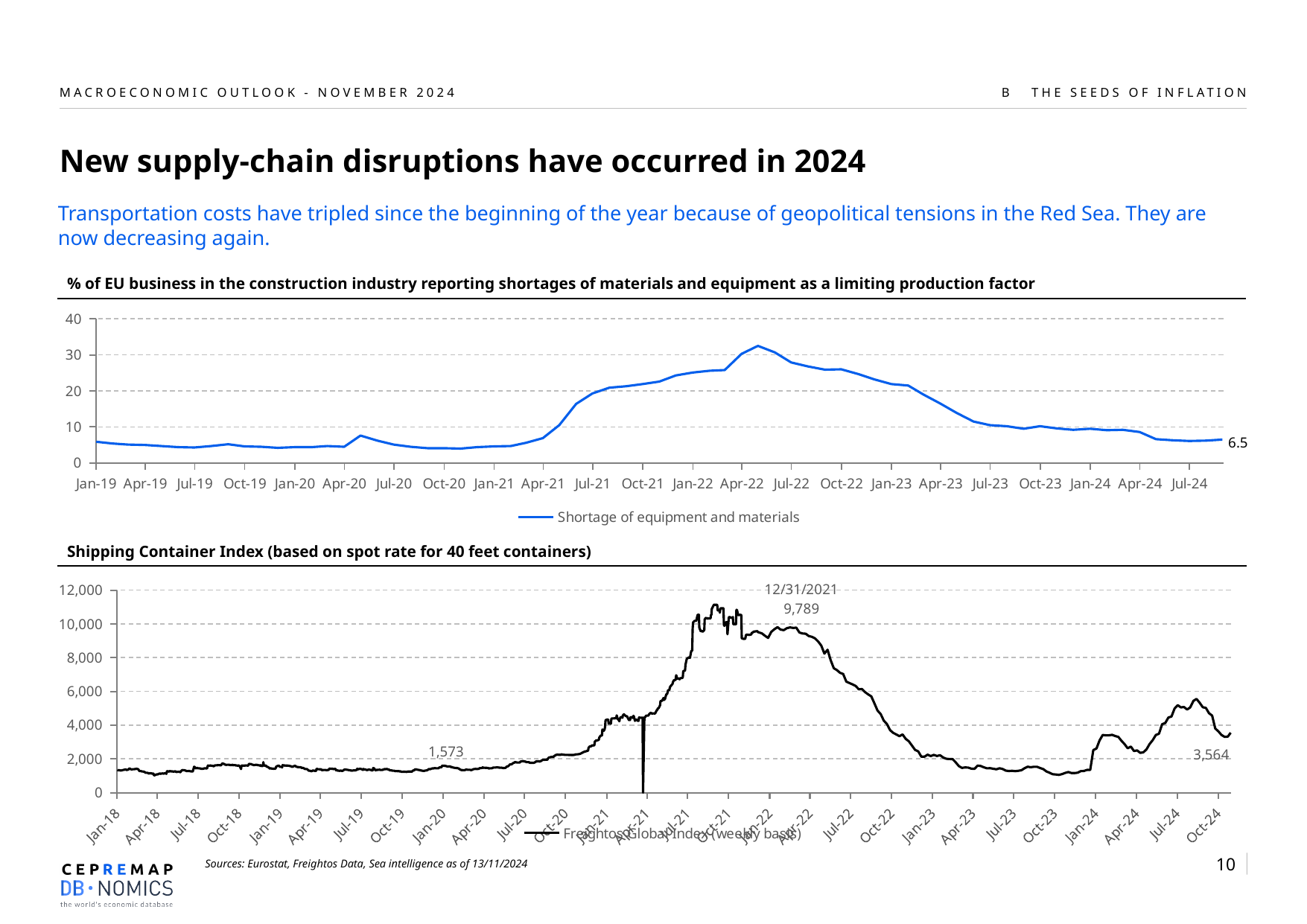
In the bottom chart, 'Shipping Container Index', which is larger: the value labelled for 12/31/2021 or the latest labelled value? 12/31/2021 In the top chart on shortages of materials and equipment, what is the latest value labelled at the end of the line? 6.5 In the bottom chart, 'Shipping Container Index', what value is labelled on the line around Jan-20? 1,573 What kind of chart is the top chart, '% of EU business in the construction industry reporting shortages of materials and equipment as a limiting production factor'? Line chart In the top chart on shortages of materials and equipment, is the peak value around Apr-22 greater or less than 30? greater In the bottom chart, 'Shipping Container Index', what value is labelled for 12/31/2021? 9,789 In the top chart on shortages of materials and equipment, do the values rise or fall between Apr-22 and Jul-24? Fall In the top chart on shortages of materials and equipment, is the value at Jan-19 greater or less than 10? less What series name does the legend of the bottom chart, 'Shipping Container Index', show? Freightos Global Index (weekly basis) In the bottom chart, 'Shipping Container Index', what is the latest value labelled at the end of the line? 3,564 How many series does the legend of the top chart on shortages of materials and equipment list? 1 In the bottom chart, 'Shipping Container Index', what is the difference between the value labelled for 12/31/2021 and the latest labelled value? 6,225